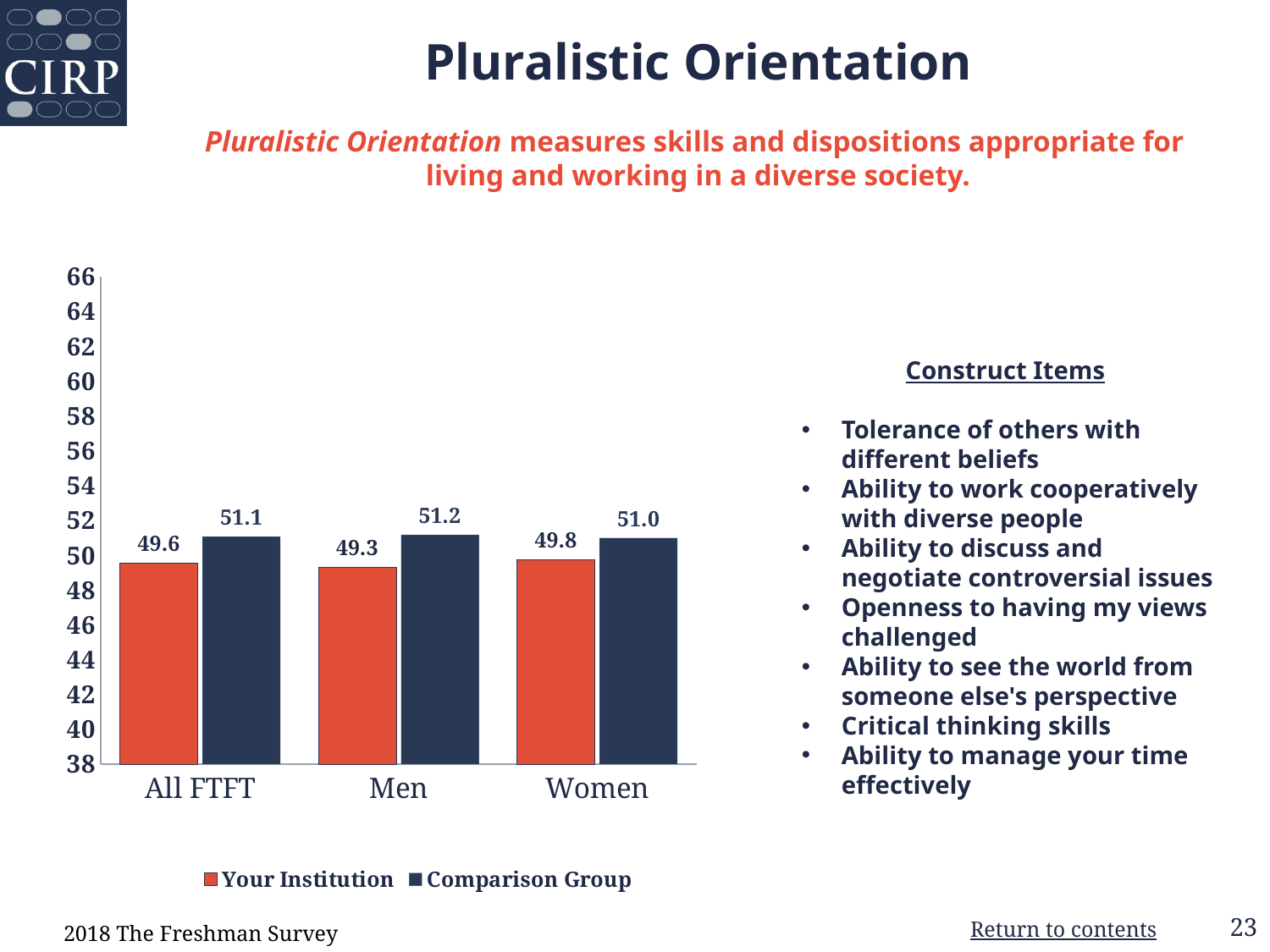
What is the value for Your Institution in the All FTFT category? 49.6 What is the difference between the Comparison Group and Your Institution values in the All FTFT category? 1.5 What kind of chart is shown on the slide? Bar chart Which category has the highest value for Your Institution? Women What is the value for Comparison Group in the Women category? 51.0 What is the difference between the Comparison Group and Your Institution values in the Men category? 1.9 How many series does the legend list? 2 Which category has the lowest value for Your Institution? Men How many categories are shown on the x axis? 3 What is the value for Your Institution in the Women category? 49.8 What is the value for Comparison Group in the Men category? 51.2 In the Women category, which is larger: Your Institution or Comparison Group? Comparison Group